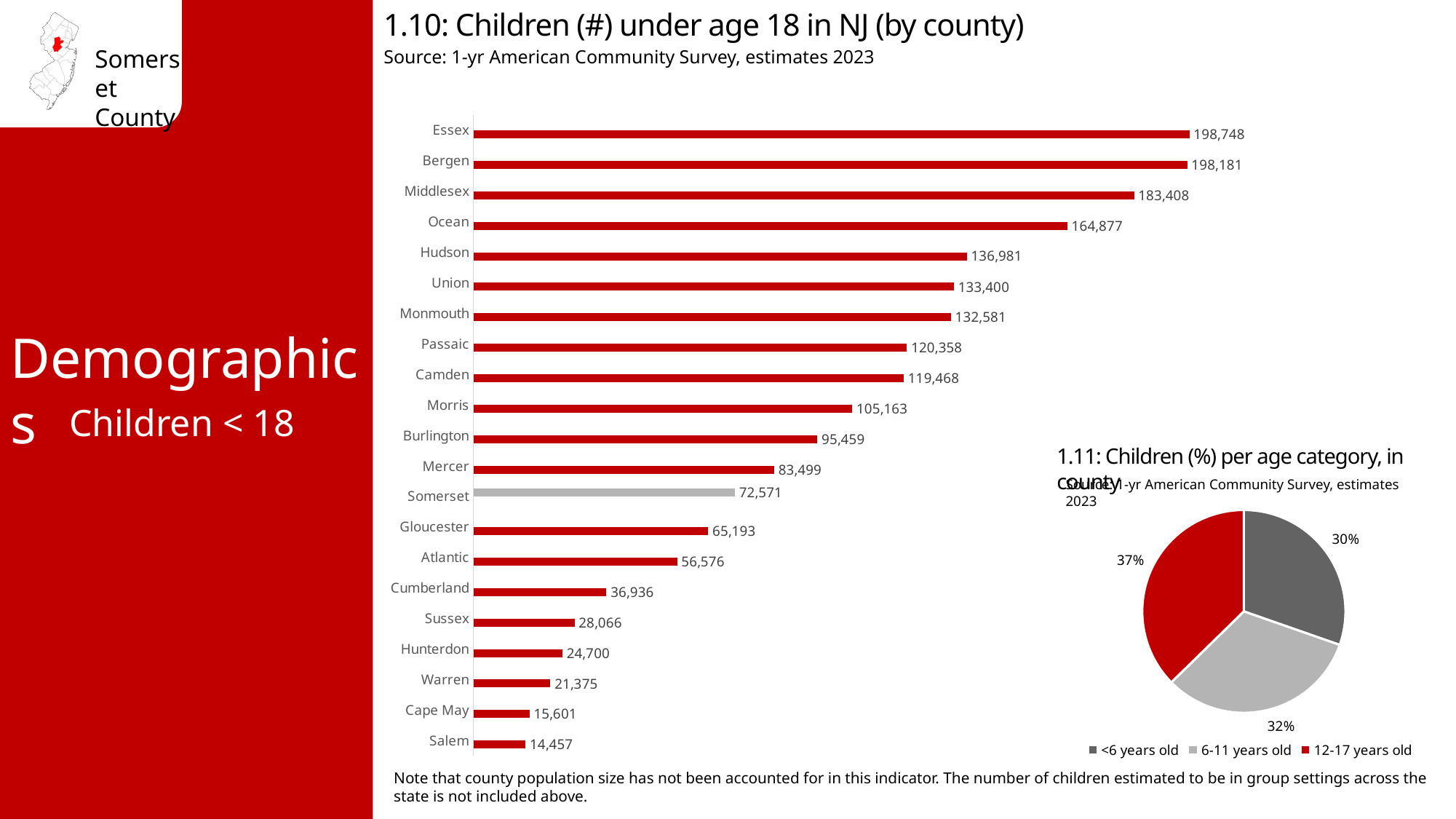
In chart 1.10, what is the value for Hudson? 136,981 How many categories does the legend of chart 1.11 list? 3 In chart 1.11, what share of children are 6-11 years old? 32% In chart 1.11, which age category has the largest share? 12-17 years old In chart 1.10, which has more children under 18, Passaic or Camden? Passaic In chart 1.10, which county has the highest number of children under 18? Essex In chart 1.10, what is the difference between Mercer and Somerset? 10,928 In chart 1.10, how many counties are shown? 21 In chart 1.10, which county's bar is shown in grey instead of red? Somerset In chart 1.10, how many children under age 18 are in Somerset County? 72,571 In chart 1.10, which county has the lowest number of children under 18? Salem What type of chart is chart 1.10? Bar chart